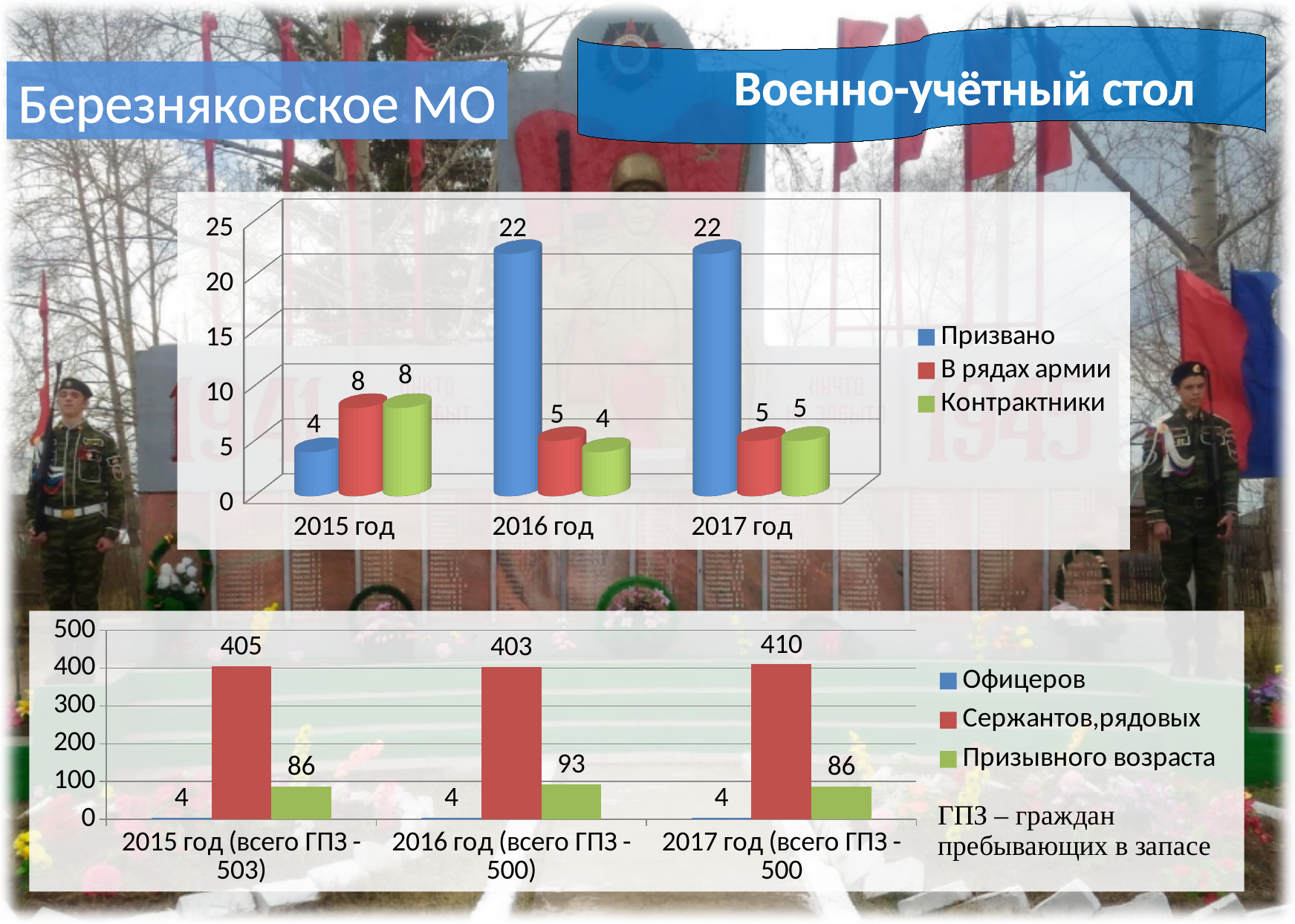
In the bottom chart, what is the value for Призывного возраста in 2016 год? 93 In the bottom chart, which is larger: Призывного возраста in 2016 год or Призывного возраста in 2015 год? 2016 год In the top chart, what is the value for Призвано in 2016 год? 22 In the top chart, what is the difference between Призвано in 2016 год and Призвано in 2015 год? 18 In the bottom chart, is the value for Сержантов,рядовых in 2016 год greater or less than 400? greater In the bottom chart, what is the value for Сержантов,рядовых in 2017 год? 410 In the top chart, which year has the lowest value for Призвано? 2015 год In the top chart, what kind of chart is shown? bar chart In the bottom chart, how many categories are shown on the x axis? 3 In the bottom chart, which year has the highest value for Сержантов,рядовых? 2017 год (всего ГПЗ - 500 In the top chart, how many series does the legend list? 3 In the top chart, what is the value for Контрактники in 2015 год? 8